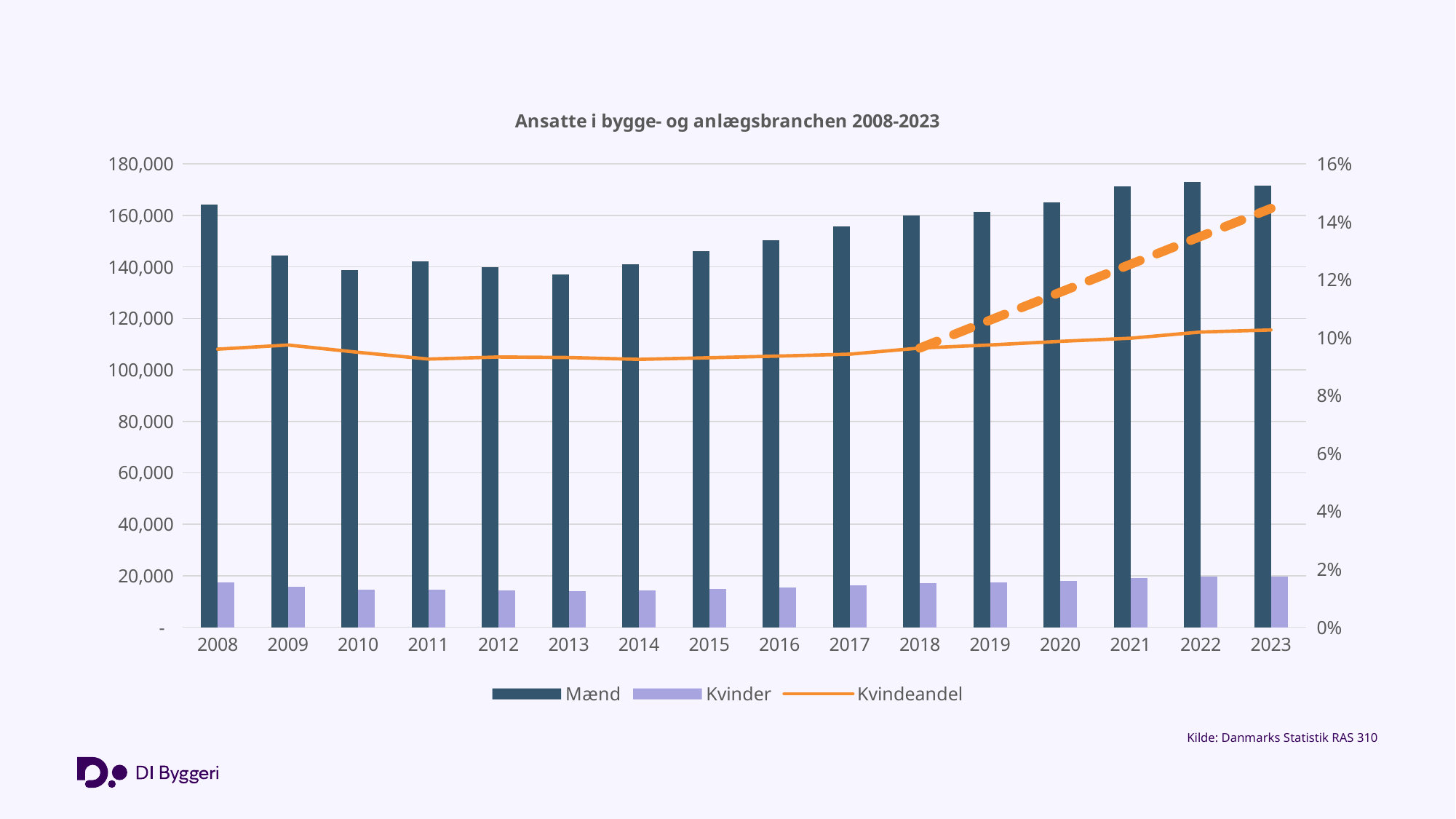
What kind of chart is this? Bar chart with a line What is the title of the chart? Ansatte i bygge- og anlægsbranchen 2008-2023 Is the value for Mænd in 2008 greater or less than 160,000? greater Which series is shown as an orange line? Kvindeandel Is the value for Mænd in 2013 greater or less than 140,000? less Which is larger, the Mænd value for 2008 or the Mænd value for 2009? 2008 How many years are shown on the x axis? 16 In which year is the Mænd bar highest? 2022 Does the Kvindeandel line rise or fall from 2014 to 2023? rise Is the Kvindeandel value for 2023 greater or less than 10%? greater How many series does the legend list? 3